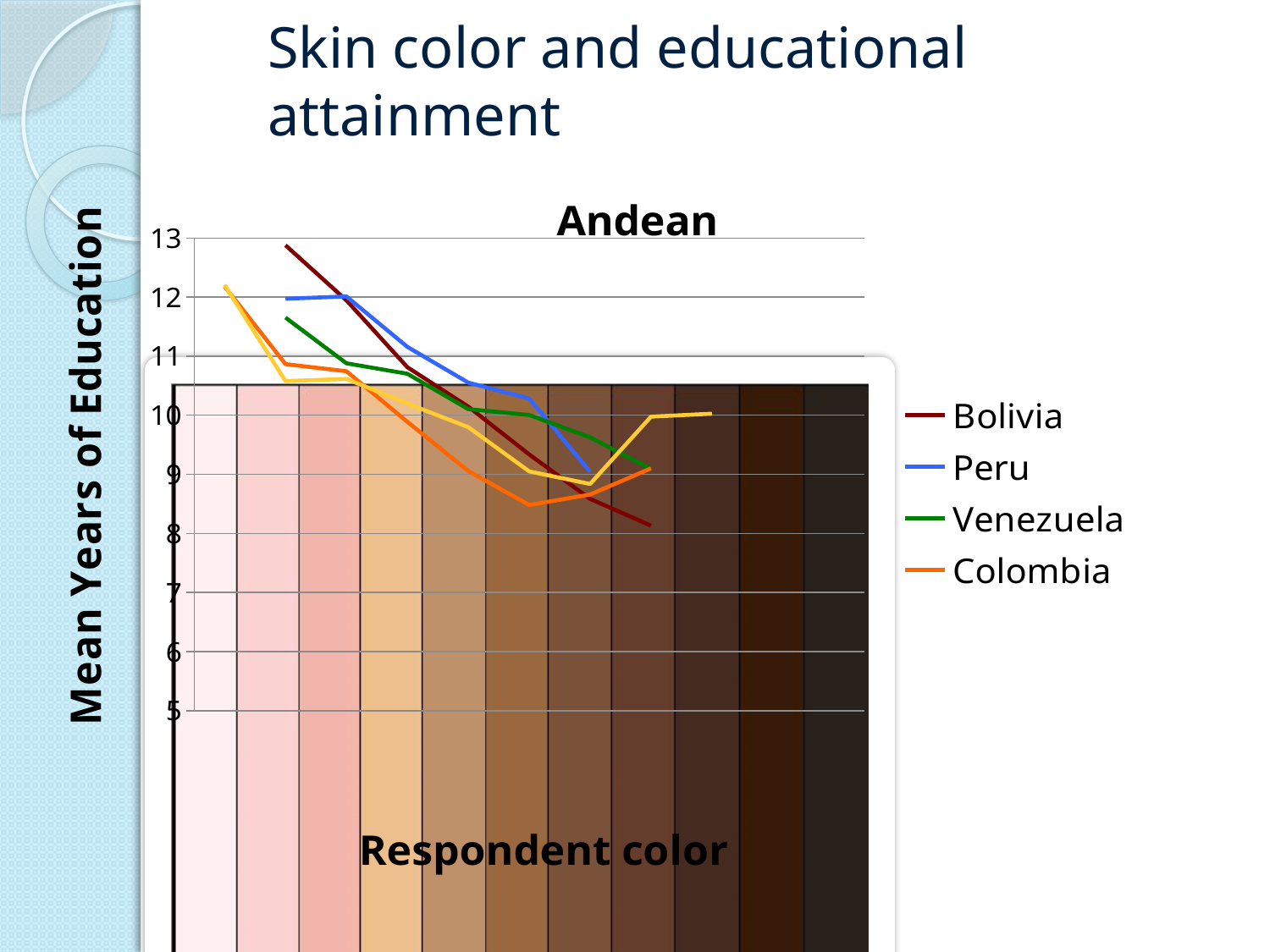
Which series reaches the highest value anywhere on the chart? Bolivia How many series does the legend list? 4 Do the values for Bolivia rise or fall moving from left to right along the x axis? fall Do the values for Peru rise or fall moving from left to right along the x axis? fall Is the first (leftmost) value for Peru greater or less than 11? greater What is the label on the vertical axis of the chart? Mean Years of Education Is the highest value for Bolivia greater or less than 12? greater At their leftmost points, which series is higher, Bolivia or Venezuela? Bolivia What is the title of the chart? Andean Is the lowest value for Bolivia greater or less than 9? less What kind of chart is shown on the slide? line chart